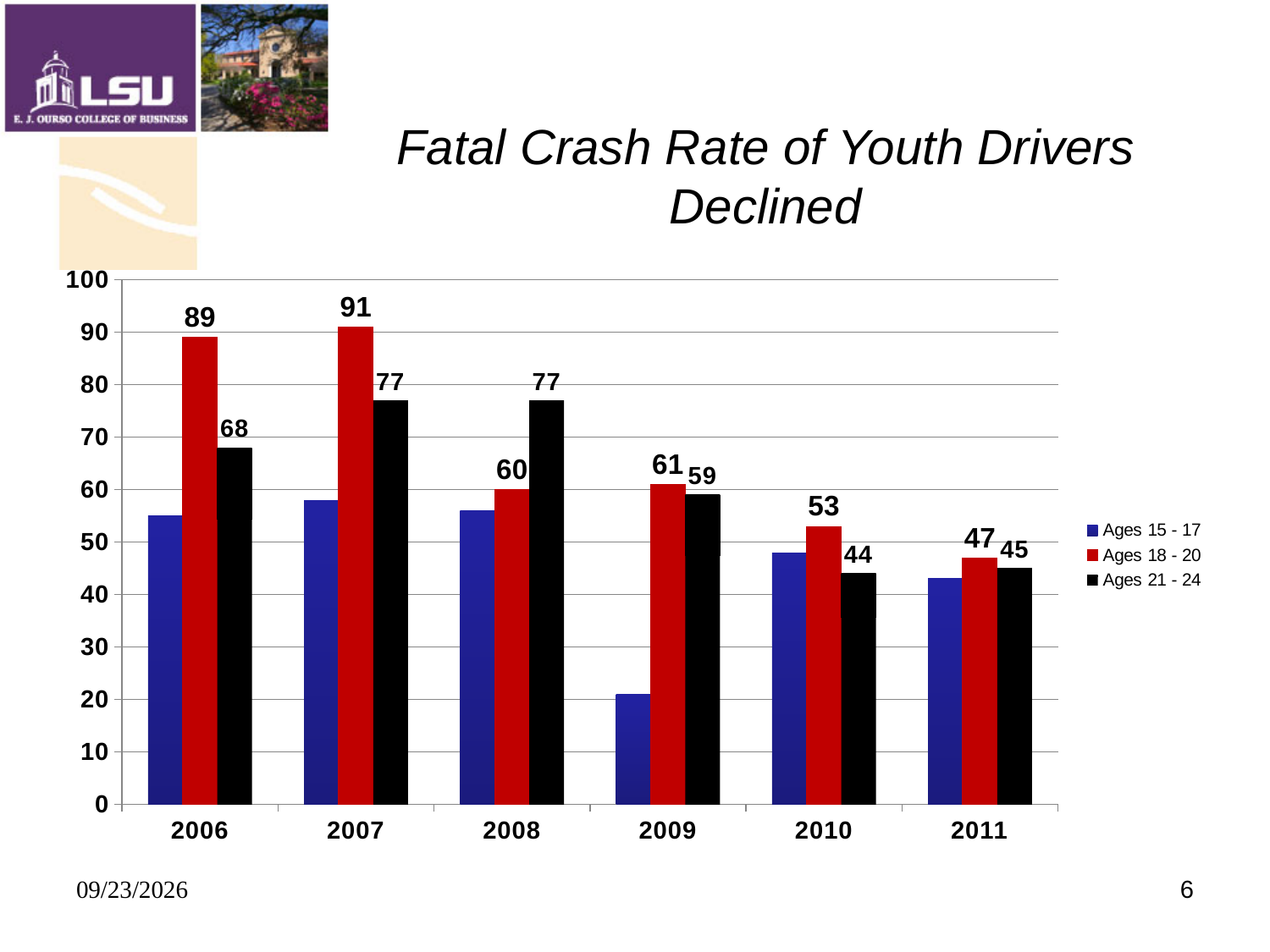
How many years are shown on the x axis? 6 How many series does the legend list? 3 Is the value for Ages 15 - 17 in 2006 greater or less than 50? greater What kind of chart is shown on the slide? bar chart In which year is the value for Ages 21 - 24 the lowest? 2010 What is the value for Ages 18 - 20 in 2007? 91 What is the difference between the Ages 18 - 20 value and the Ages 21 - 24 value in 2006? 21 Do the values for Ages 18 - 20 rise or fall from 2007 to 2011? fall What is the value for Ages 21 - 24 in 2010? 44 Is the value for Ages 15 - 17 in 2009 greater or less than 30? less In 2008, which is larger: the value for Ages 18 - 20 or the value for Ages 21 - 24? Ages 21 - 24 In which year is the value for Ages 18 - 20 the highest? 2007